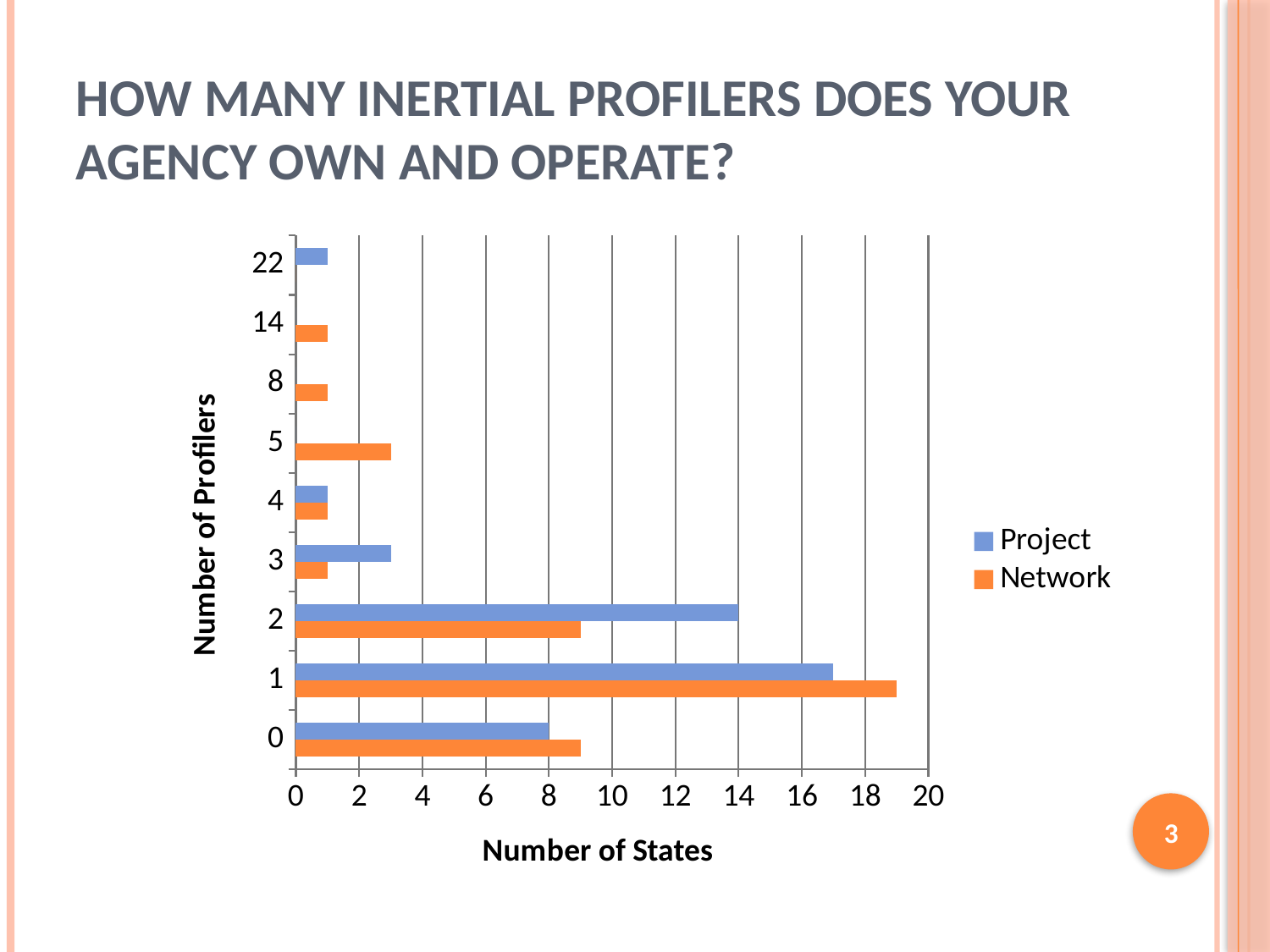
What is the Project value for 2 profilers? 14 For 2 profilers, which series has the larger value, Project or Network? Project For which number of profilers is the Project series highest? 1 Is the Network value for 1 profiler greater or less than 18? greater Is the Project value for 1 profiler greater or less than 16? greater How many categories (number of profilers) are shown on the vertical axis? 9 For which number of profilers is the Network series highest? 1 How many series does the legend list? 2 What type of chart is shown on the slide? Bar chart What is the title of the horizontal axis? Number of States What is the Project value for 0 profilers? 8 For 1 profiler, which series has the larger value, Project or Network? Network